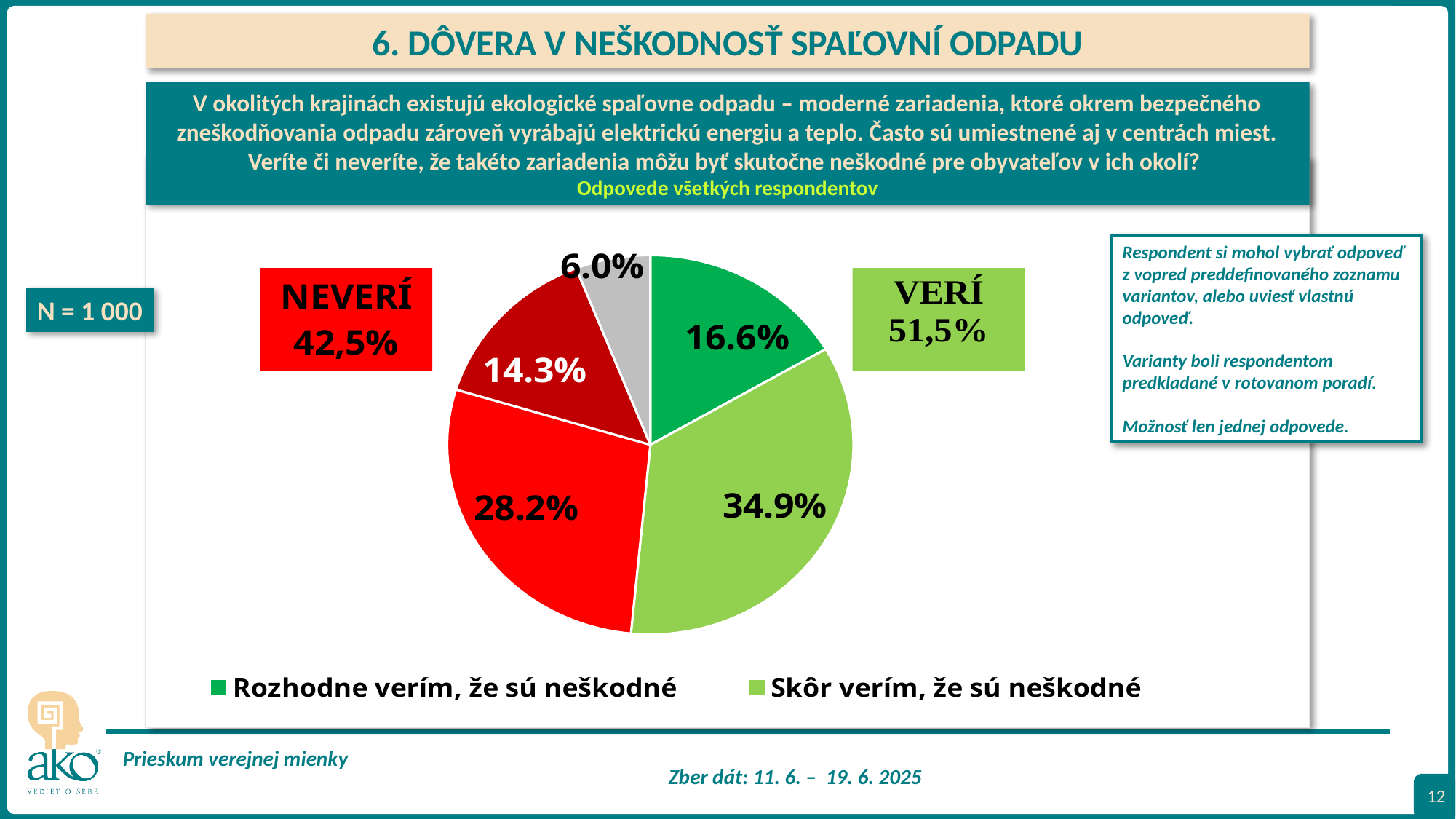
Which is larger: the "Rozhodne verím, že sú neškodné" slice or the bright red 28.2% slice? the bright red 28.2% slice Which slice of the pie chart is the smallest? the grey slice (6.0%) What total percentage is shown in the green "VERÍ" box next to the pie chart? 51,5% What percentage is shown on the dark red slice of the pie chart? 14.3% What share of respondents chose "Skôr verím, že sú neškodné"? 34.9% What percentage is shown on the grey slice of the pie chart? 6.0% How many slices does the pie chart have? 5 What share of respondents chose "Rozhodne verím, že sú neškodné"? 16.6% What is the difference between the "Skôr verím, že sú neškodné" slice and the "Rozhodne verím, že sú neškodné" slice? 18.3 percentage points What kind of chart is shown on the slide? pie chart What percentage is shown on the bright red slice of the pie chart? 28.2% Which slice of the pie chart is the largest? Skôr verím, že sú neškodné (34.9%)